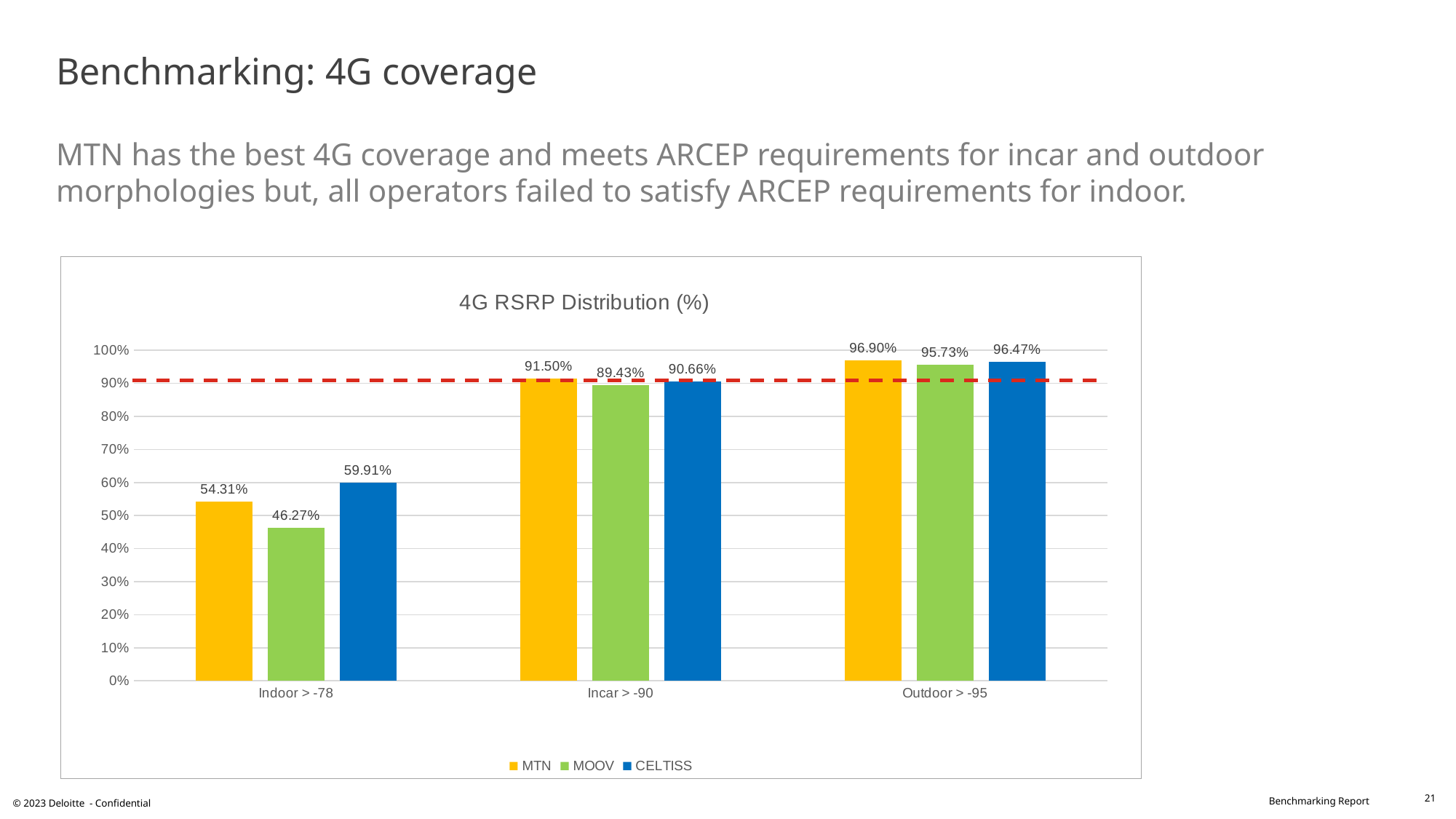
What kind of chart is shown on the slide? Bar chart Which operator has the highest value in the Indoor > -78 category? CELTISS Which is larger: the CELTISS value for Incar > -90 or the MOOV value for Incar > -90? CELTISS What is the value for MTN in the Indoor > -78 category? 54.31% What is the value for MOOV in the Incar > -90 category? 89.43% How many series does the legend list? 3 What is the title of the chart? 4G RSRP Distribution (%) Is the value for MOOV in the Indoor > -78 category greater or less than 50%? less What is the value for CELTISS in the Outdoor > -95 category? 96.47% How many categories are shown on the x axis? 3 Which operator has the lowest value in the Incar > -90 category? MOOV What is the difference between the MTN and MOOV values in the Indoor > -78 category? 8.04%